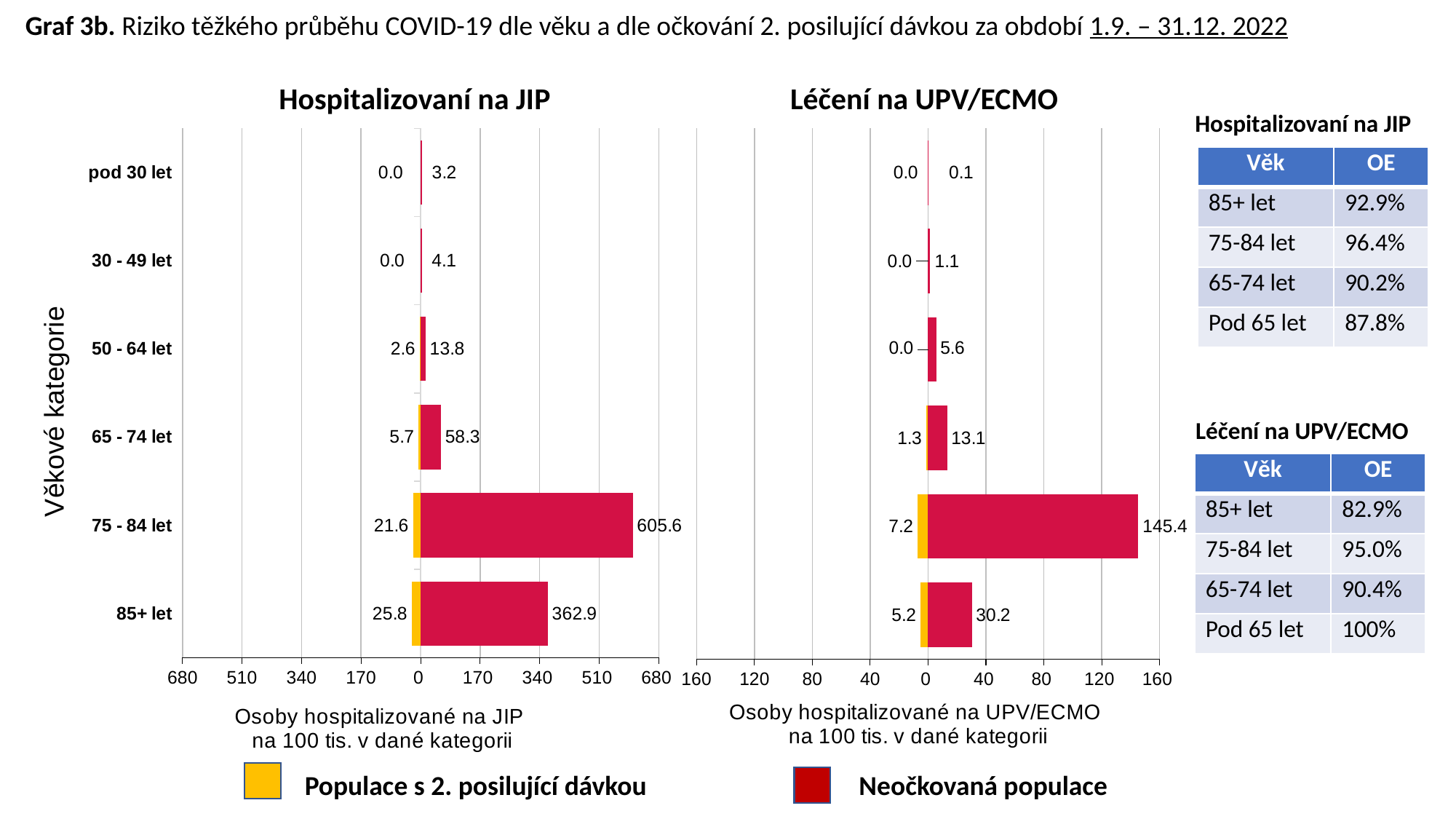
In the chart 'Léčení na UPV/ECMO', which is larger for the unvaccinated population: the value for 85+ let or the value for 65 - 74 let? 85+ let In the chart 'Hospitalizovaní na JIP', what is the difference between the unvaccinated population values for 75 - 84 let and 85+ let? 242.7 In the chart 'Léčení na UPV/ECMO', which age category has the lowest value for the unvaccinated population? pod 30 let In the chart 'Léčení na UPV/ECMO', what is the value for the population with a 2nd booster dose in the 75 - 84 let category? 7.2 In the chart 'Hospitalizovaní na JIP', what is the value for the unvaccinated population (Neočkovaná populace) in the 75 - 84 let category? 605.6 In the chart 'Hospitalizovaní na JIP', is the unvaccinated population value for 85+ let greater or less than 340? greater In the chart 'Hospitalizovaní na JIP', what is the value for the population with a 2nd booster dose in the 85+ let category? 25.8 In the chart 'Hospitalizovaní na JIP', which age category has the highest value for the unvaccinated population? 75 - 84 let How many age categories are shown in the chart 'Léčení na UPV/ECMO'? 6 How many series does the legend list for the charts on the slide? 2 In the chart 'Léčení na UPV/ECMO', what is the value for the unvaccinated population in the 65 - 74 let category? 13.1 What kind of chart is 'Hospitalizovaní na JIP'? Bar chart